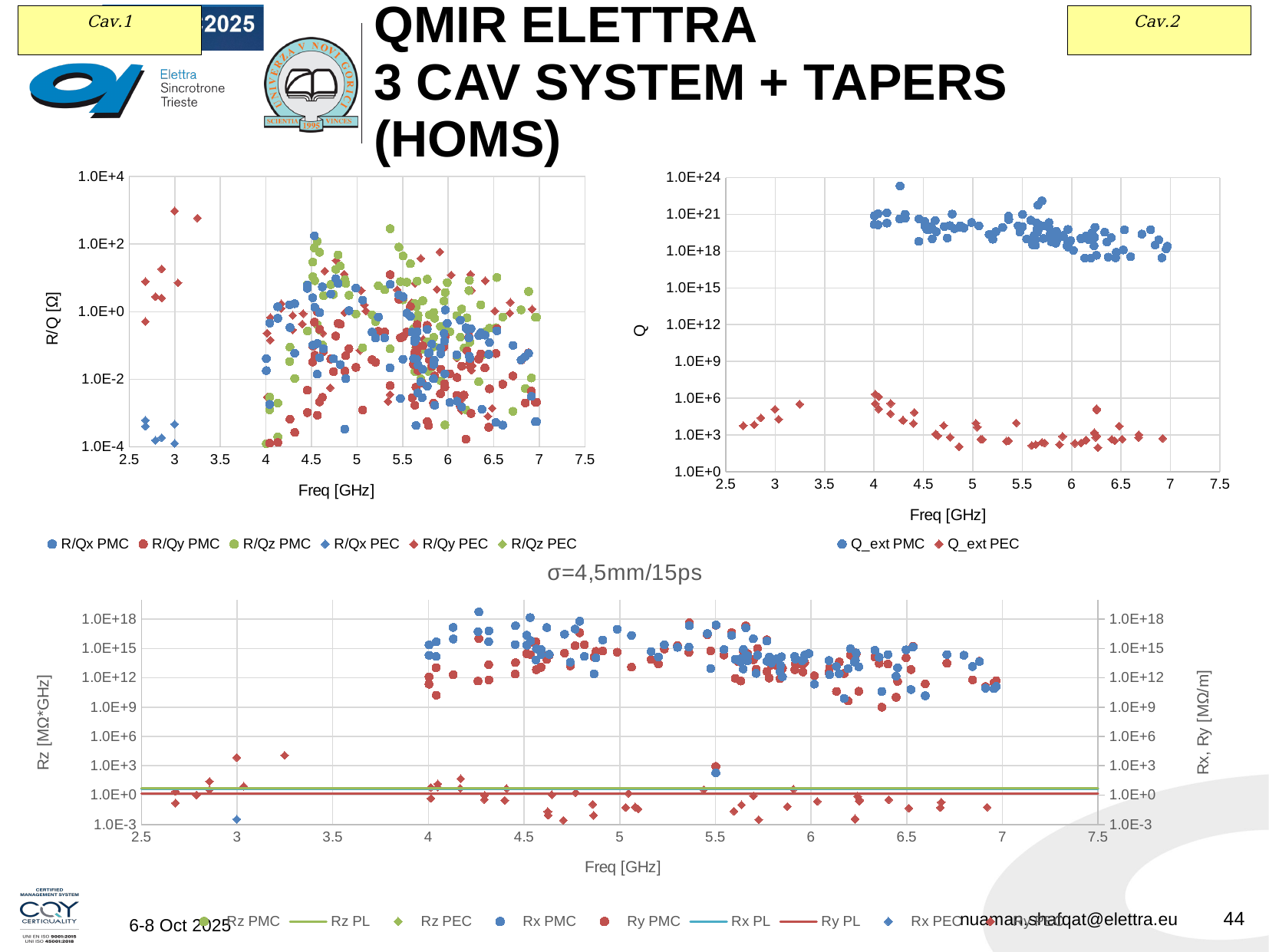
What is the label of the right-hand y axis of the bottom chart? Rx, Ry [MΩ/m] What is the title of the bottom chart? σ=4,5mm/15ps In the top-right Q chart, are the Q_ext PMC values greater or less than 1.0E+15? greater In the top-right Q chart, do the Q_ext PMC values generally rise or fall as frequency increases from 4 GHz to 7 GHz? fall What kind of chart is the top-left chart with the y axis labelled R/Q [Ω]? scatter chart What is the highest tick value shown on the y axis of the top-right Q chart? 1.0E+24 How many series does the legend of the top-right Q chart list? 2 In the top-right Q chart, which series has the higher values, Q_ext PMC or Q_ext PEC? Q_ext PMC How many series does the legend of the top-left R/Q chart list? 6 In the top-right Q chart, are the Q_ext PEC values greater or less than 1.0E+9? less